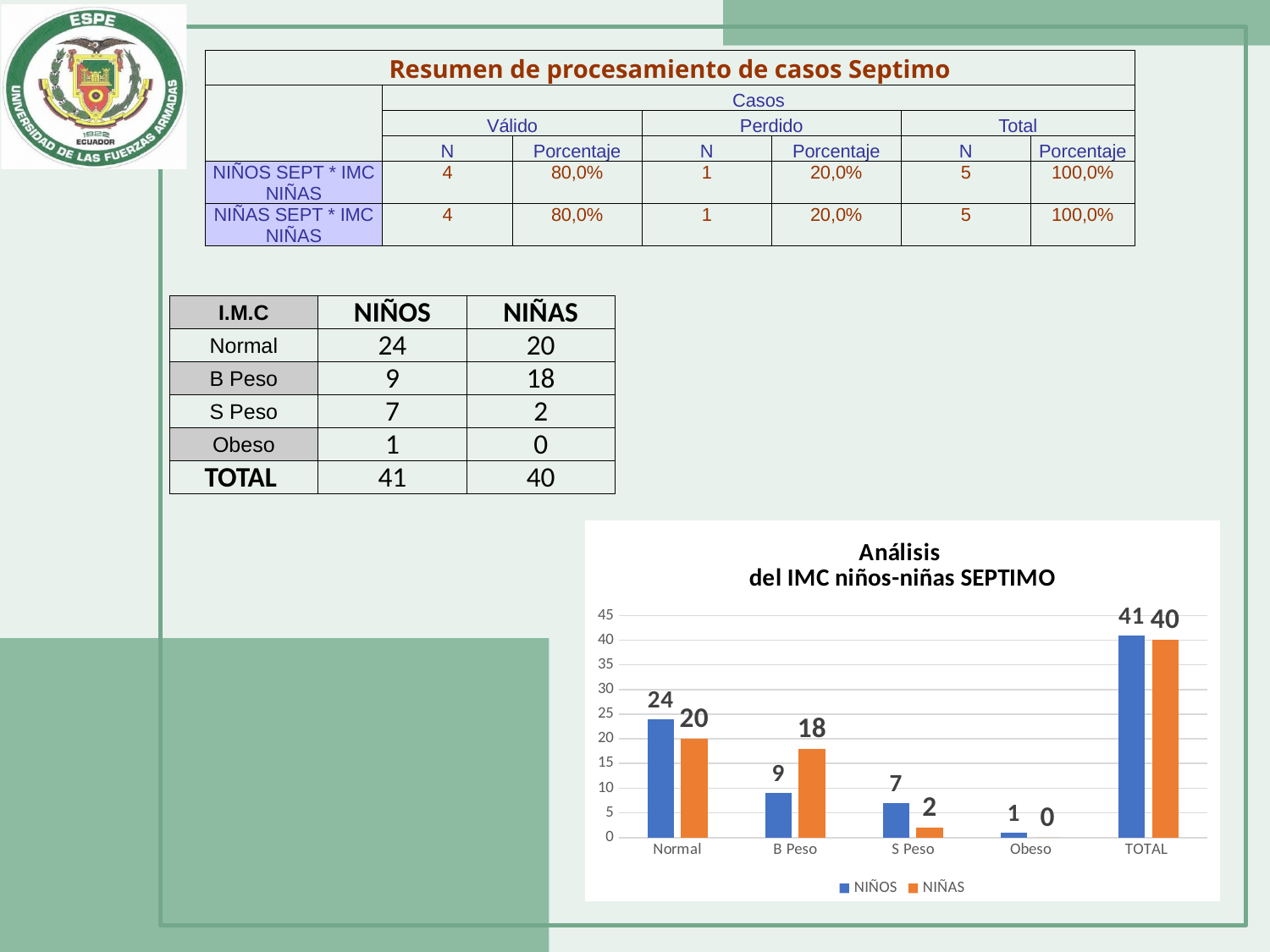
What is the value for NIÑAS in the Obeso category? 0 What is the value for NIÑOS in the Normal category? 24 How many series does the chart legend list? 2 What colour are the NIÑAS bars in the chart? Orange What is the title of the chart? Análisis del IMC niños-niñas SEPTIMO Which category has the lowest value for NIÑAS? Obeso What kind of chart is shown on the slide? Bar chart In the B Peso category, which series has the larger value, NIÑOS or NIÑAS? NIÑAS Excluding the TOTAL bars, which category has the highest value for NIÑOS? Normal How many categories are shown on the x axis of the chart? 5 What is the difference between NIÑOS and NIÑAS in the S Peso category? 5 What is the value for NIÑAS in the B Peso category? 18